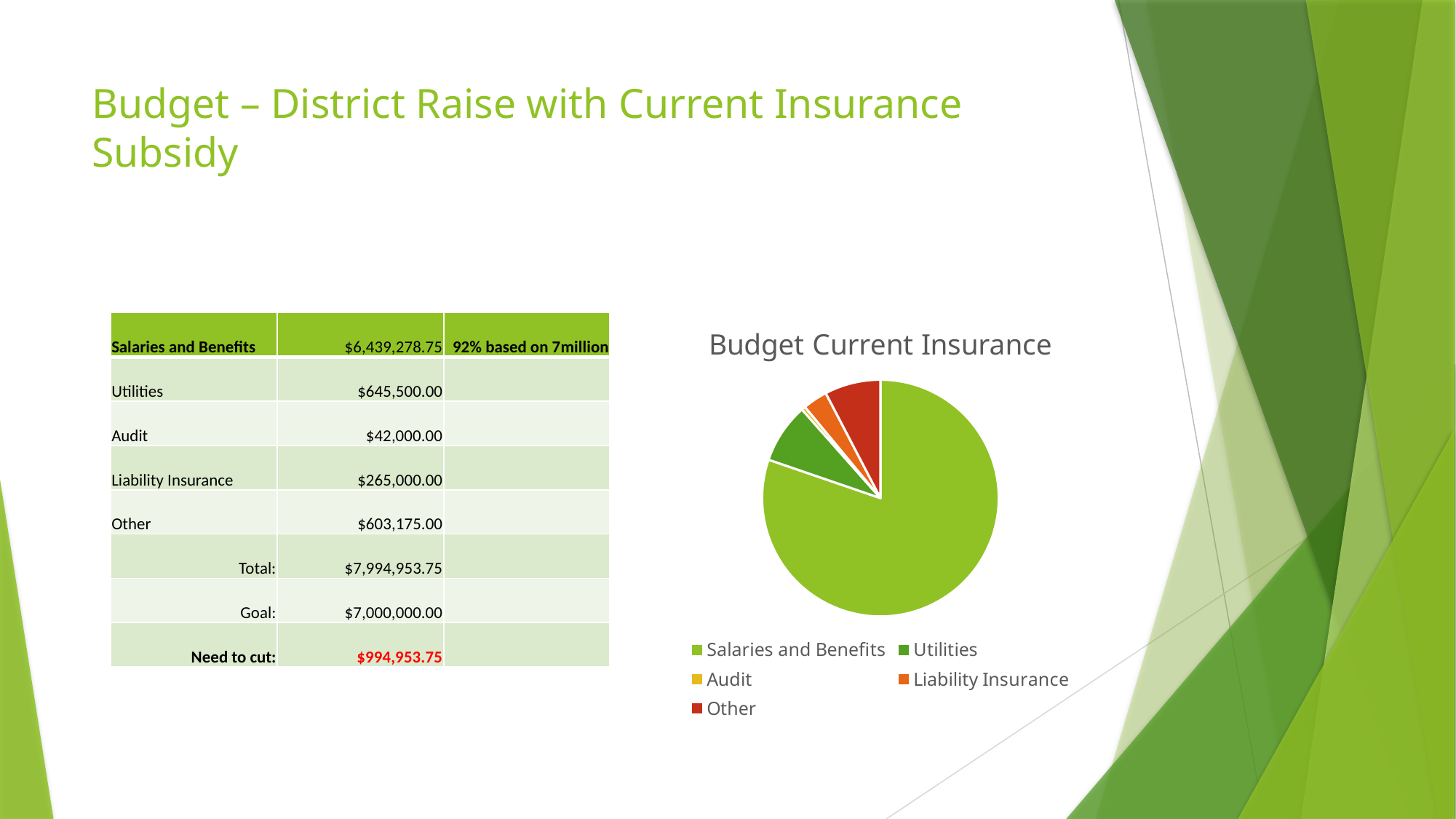
How many slices does the pie chart have? 5 According to the table on the slide, what is the value for Salaries and Benefits? $6,439,278.75 What is the title of the pie chart? Budget Current Insurance In the pie chart, which slice is larger: Utilities or Liability Insurance? Utilities According to the table on the slide, what is the value for Liability Insurance? $265,000.00 In the pie chart, which slice is larger: Other or Audit? Other What kind of chart is shown on the slide? pie chart Which category has the smallest slice in the pie chart? Audit Which category has the largest slice in the pie chart? Salaries and Benefits How many entries does the pie chart's legend list? 5 What colour is the Other slice in the pie chart? red According to the table on the slide, what is the value for Utilities? $645,500.00